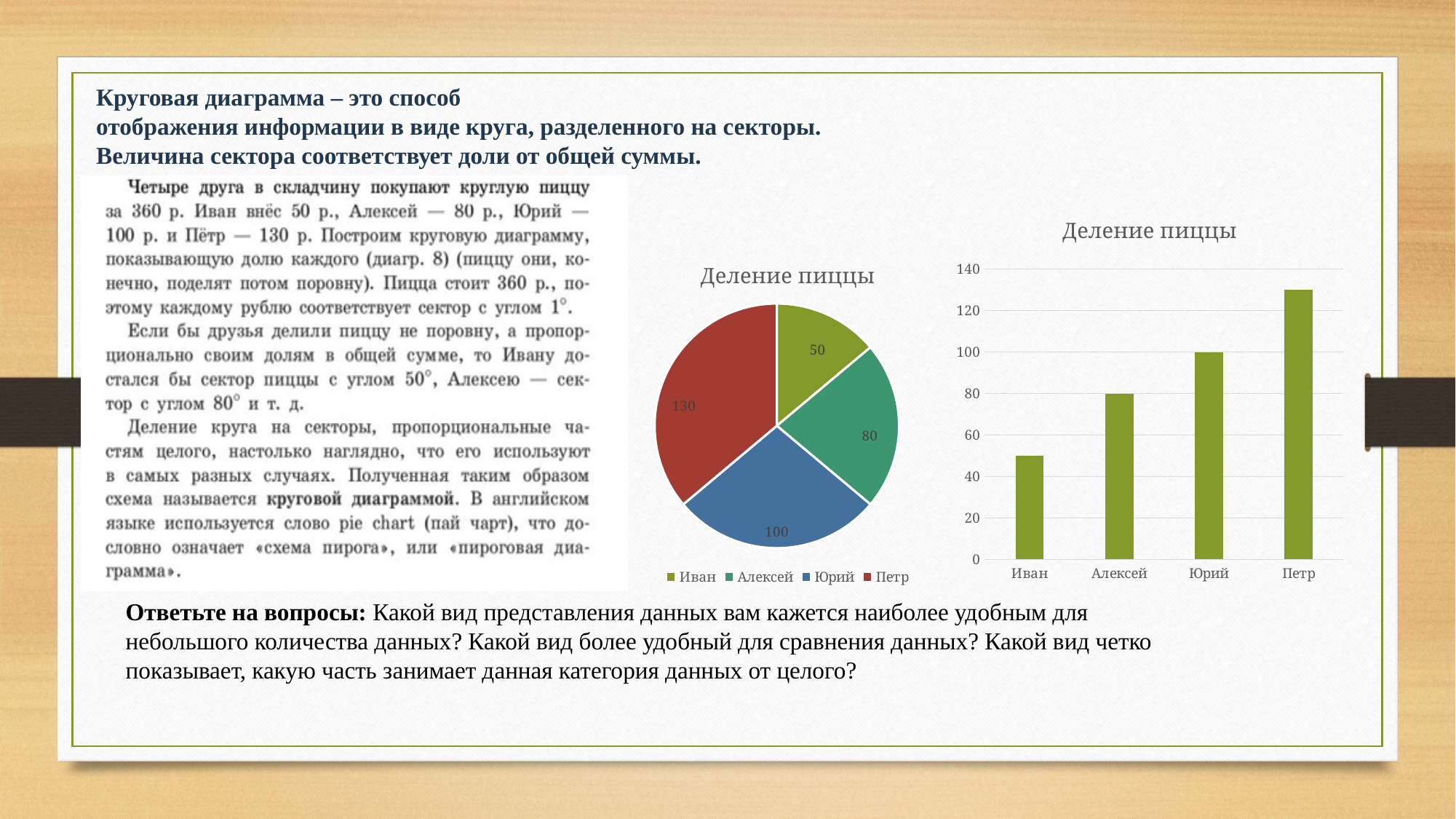
What kind of chart is the chart on the right side of the slide? Bar chart In the bar chart, is the value for Петр greater or less than 120? greater In the pie chart, what value is shown for Петр? 130 In the bar chart, what is the value for Юрий? 100 In the pie chart, which person has the smallest slice? Иван In the pie chart, which person has the largest slice? Петр In the bar chart, do the values rise or fall from left to right along the x axis? Rise In the pie chart, what value is shown for Иван? 50 In the pie chart, what is the total of all four slices? 360 How many entries does the legend of the pie chart list? 4 In the pie chart, what is the difference between the values for Юрий and Алексей? 20 What is the title of the bar chart? Деление пиццы